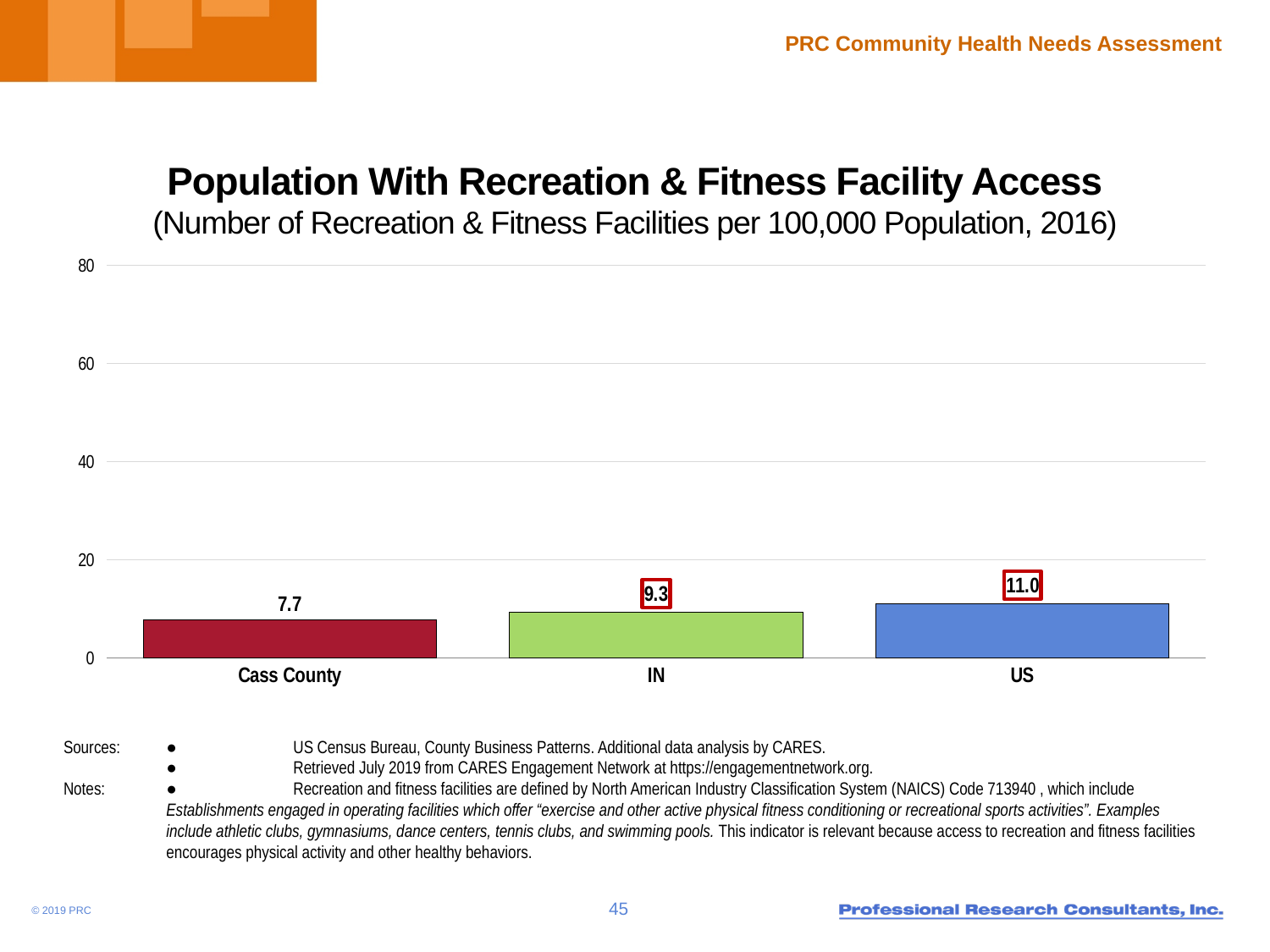
Is the value for US greater or less than 20? less What is the value for IN? 9.3 What is the title of the chart? Population With Recreation & Fitness Facility Access What is the difference between the IN value and the Cass County value? 1.6 What is the difference between the US value and the Cass County value? 3.3 Which category has the highest value? US Which category has the lowest value? Cass County What is the value for Cass County? 7.7 How many categories are shown on the chart? 3 What kind of chart is shown on the slide? bar chart What is the value for US? 11.0 Which is larger, the value for IN or the value for Cass County? IN